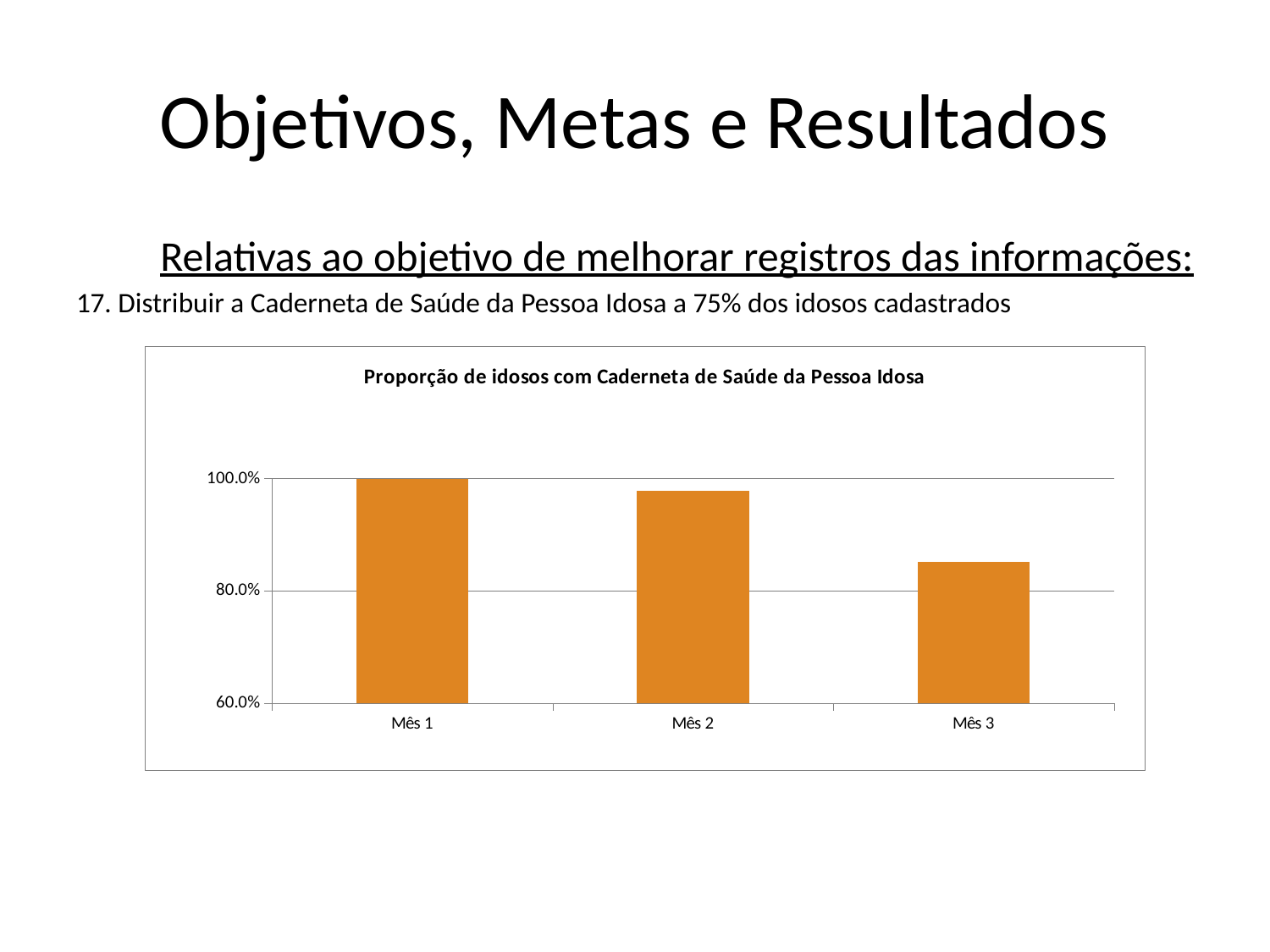
Which is larger, the value for Mês 2 or the value for Mês 3? Mês 2 How many categories (months) are plotted in the chart? 3 Do the values rise or fall from Mês 1 to Mês 3? fall Which month has the highest proportion in the chart? Mês 1 Is the value for Mês 2 greater or less than 80.0%? greater What colour are the bars in the chart? orange Is the value for Mês 2 greater or less than 100.0%? less Is the value for Mês 3 greater or less than 80.0%? greater What kind of chart is shown on the slide? bar chart What is the value for Mês 1 in the chart? 100.0% What is the title of the chart? Proporção de idosos com Caderneta de Saúde da Pessoa Idosa Which month has the lowest proportion in the chart? Mês 3